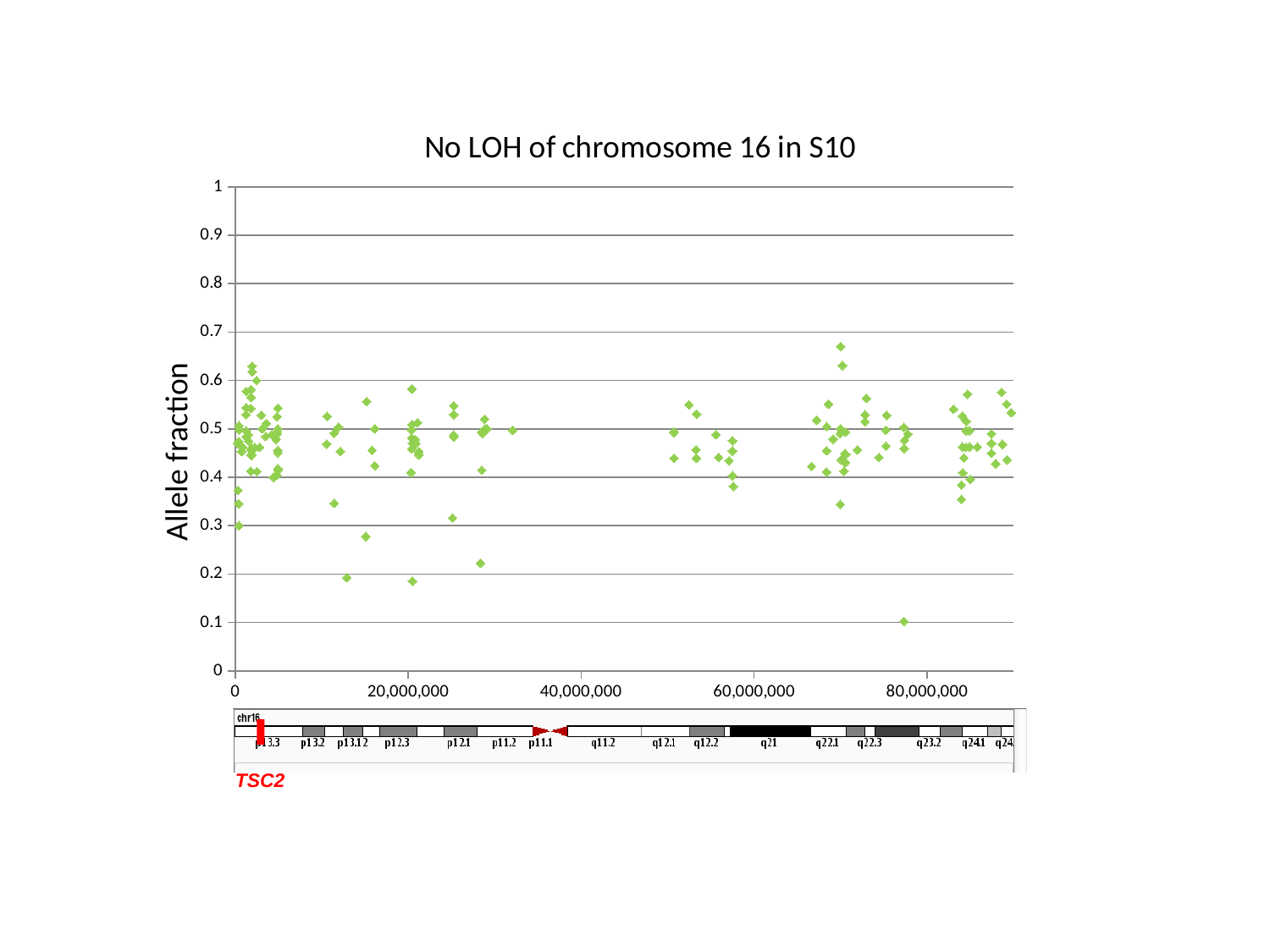
Is the lowest plotted allele fraction greater or less than 0.2? less What kind of chart is shown on the slide? scatter chart What is the highest value shown on the y axis? 1 What is the label on the y axis of the chart? Allele fraction Is the highest plotted allele fraction greater or less than 0.7? less What is the interval between consecutive tick labels on the y axis? 0.1 Around which y-axis gridline value do most of the plotted points cluster? 0.5 What is the title of the chart? No LOH of chromosome 16 in S10 What is the largest tick label shown on the x axis? 80,000,000